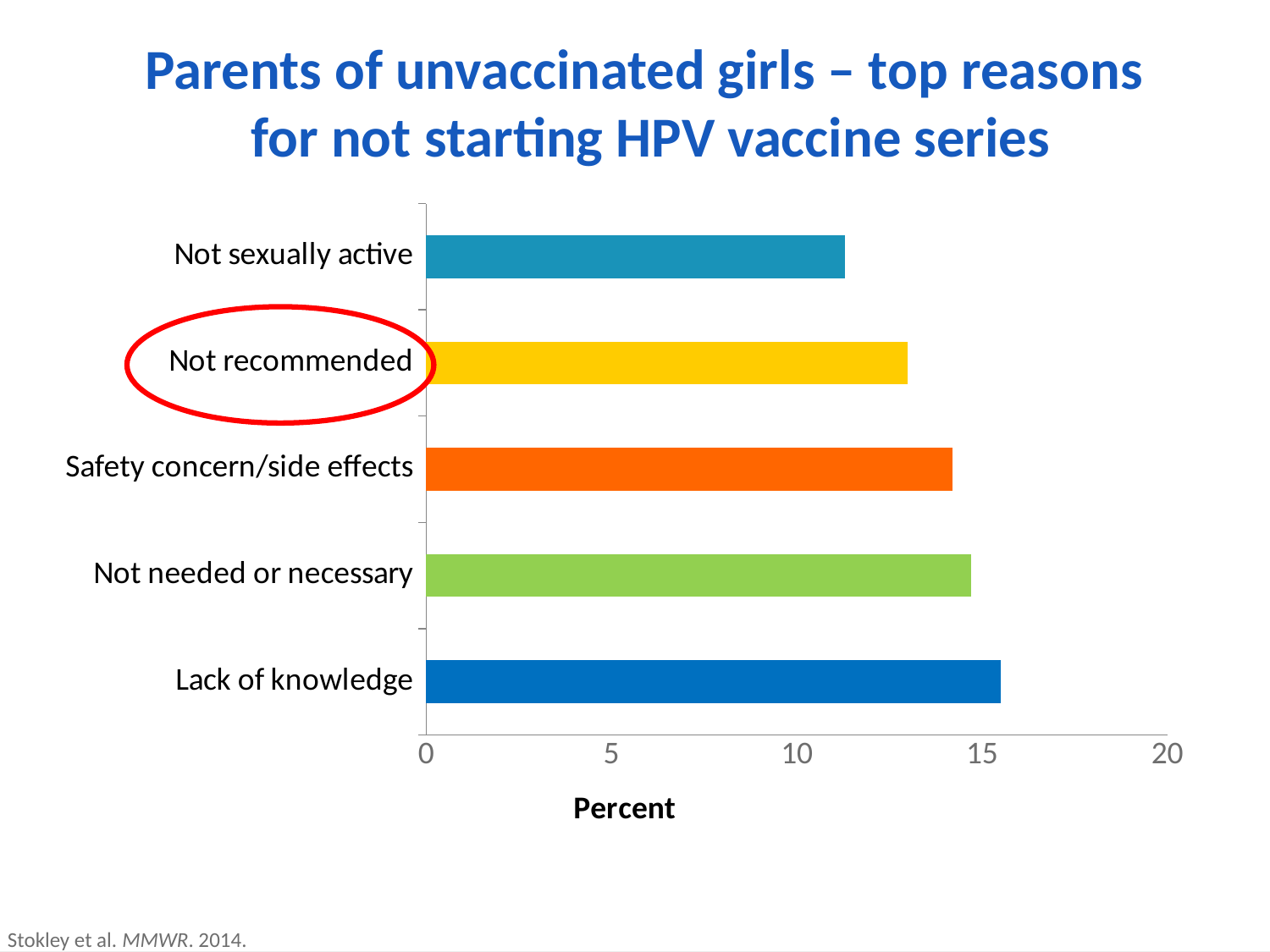
Is the value for Safety concern/side effects greater or less than 15? less Is the value for Not sexually active greater or less than 10? greater Which reason has the highest percentage? Lack of knowledge Which category label is circled in red on the slide? Not recommended Is the value for Not recommended greater or less than 15? less What is the label of the horizontal axis? Percent Which is larger, the value for Lack of knowledge or the value for Not recommended? Lack of knowledge Which reason has the lowest percentage? Not sexually active How many reasons (categories) are plotted in the chart? 5 What kind of chart is shown on the slide? bar chart